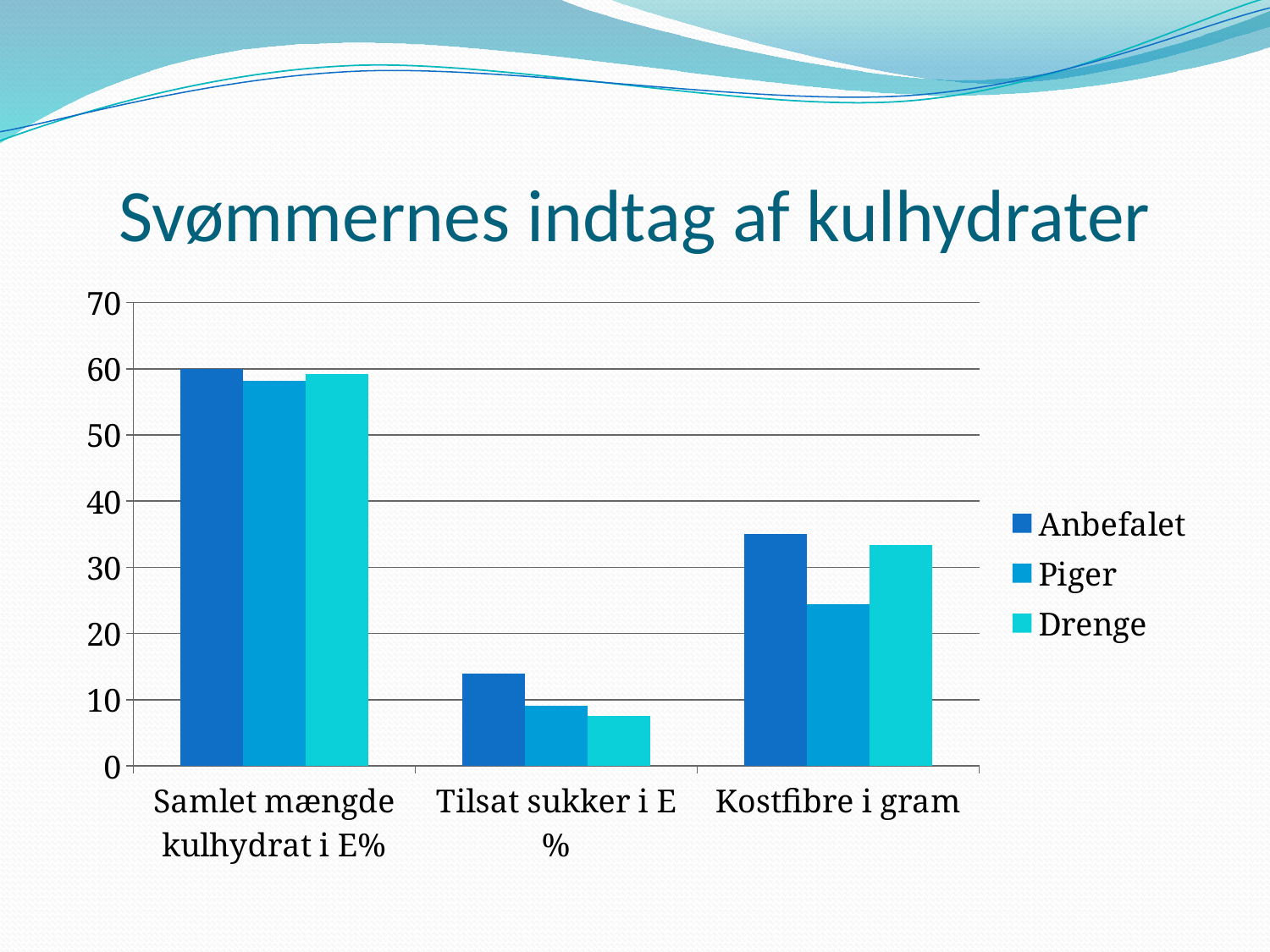
What is the title of the chart? Svømmernes indtag af kulhydrater Is the Piger value for Kostfibre i gram greater or less than 20? greater For the Piger series, which category has the lowest value? Tilsat sukker i E % Is the Anbefalet value for Kostfibre i gram greater or less than 30? greater Which series is shown in the lightest (cyan) colour in the legend? Drenge What is the Anbefalet value for Samlet mængde kulhydrat i E%? 60 For Kostfibre i gram, which is larger: the Anbefalet value or the Piger value? Anbefalet For Tilsat sukker i E %, which is larger: the Anbefalet value or the Drenge value? Anbefalet How many categories are shown on the x axis? 3 What kind of chart is shown on the slide? bar chart How many series does the legend list? 3